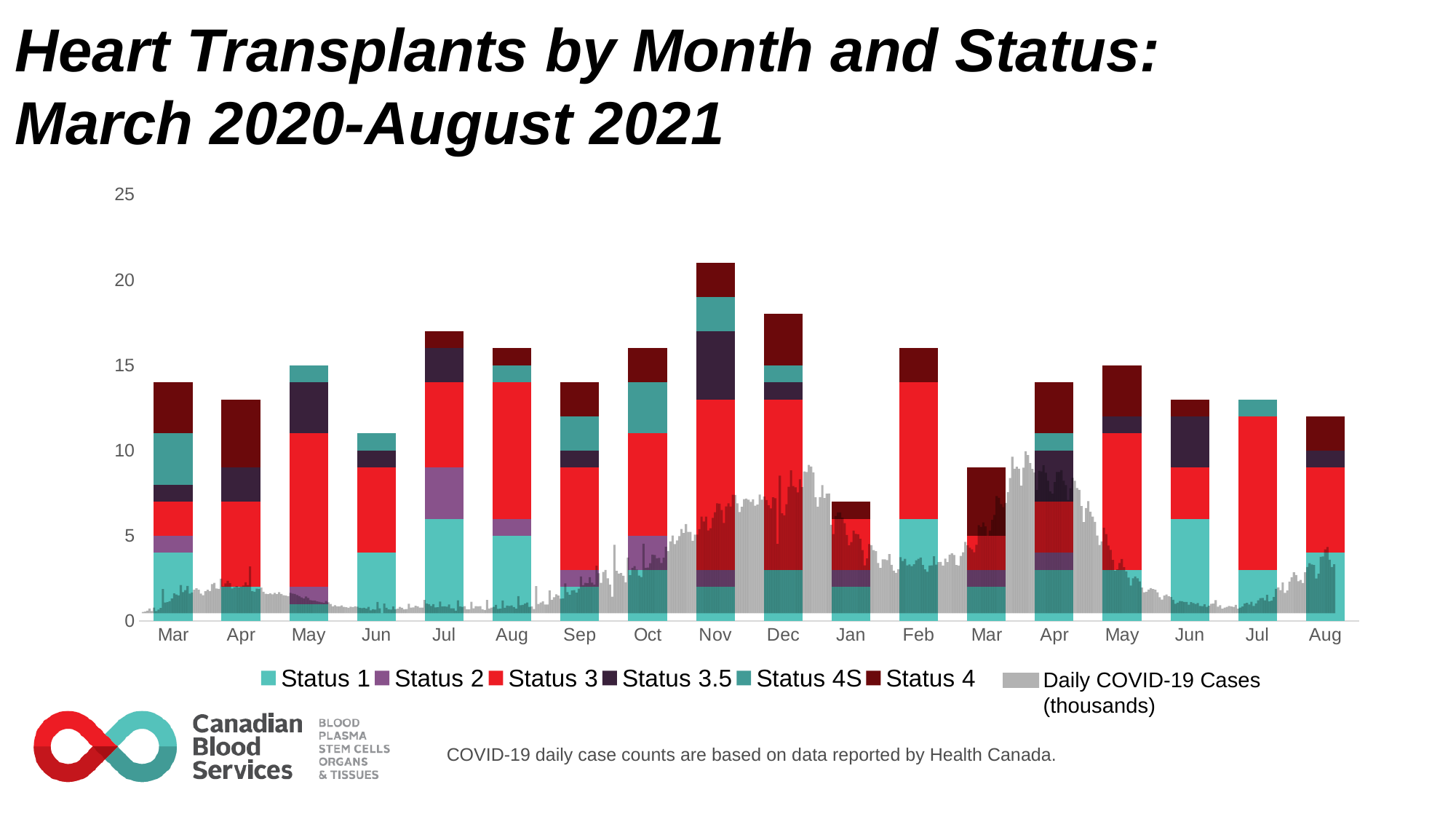
Is the total for Jan 2021 greater or less than 10? less Which month has a taller stacked bar, Nov 2020 or Jan 2021? Nov 2020 How many series does the legend list? 7 Which legend entry is shown in grey? Daily COVID-19 Cases (thousands) Is the total for Nov 2020 greater or less than 20? greater What is the title of the chart? Heart Transplants by Month and Status: March 2020-August 2021 Is the total for Mar 2021 greater or less than 10? less What kind of chart is shown on the slide? Stacked bar chart Which month has the shortest stacked bar of heart transplants? Jan (2021) Which month has the tallest stacked bar of heart transplants? Nov (2020) How many months are shown on the x axis? 18